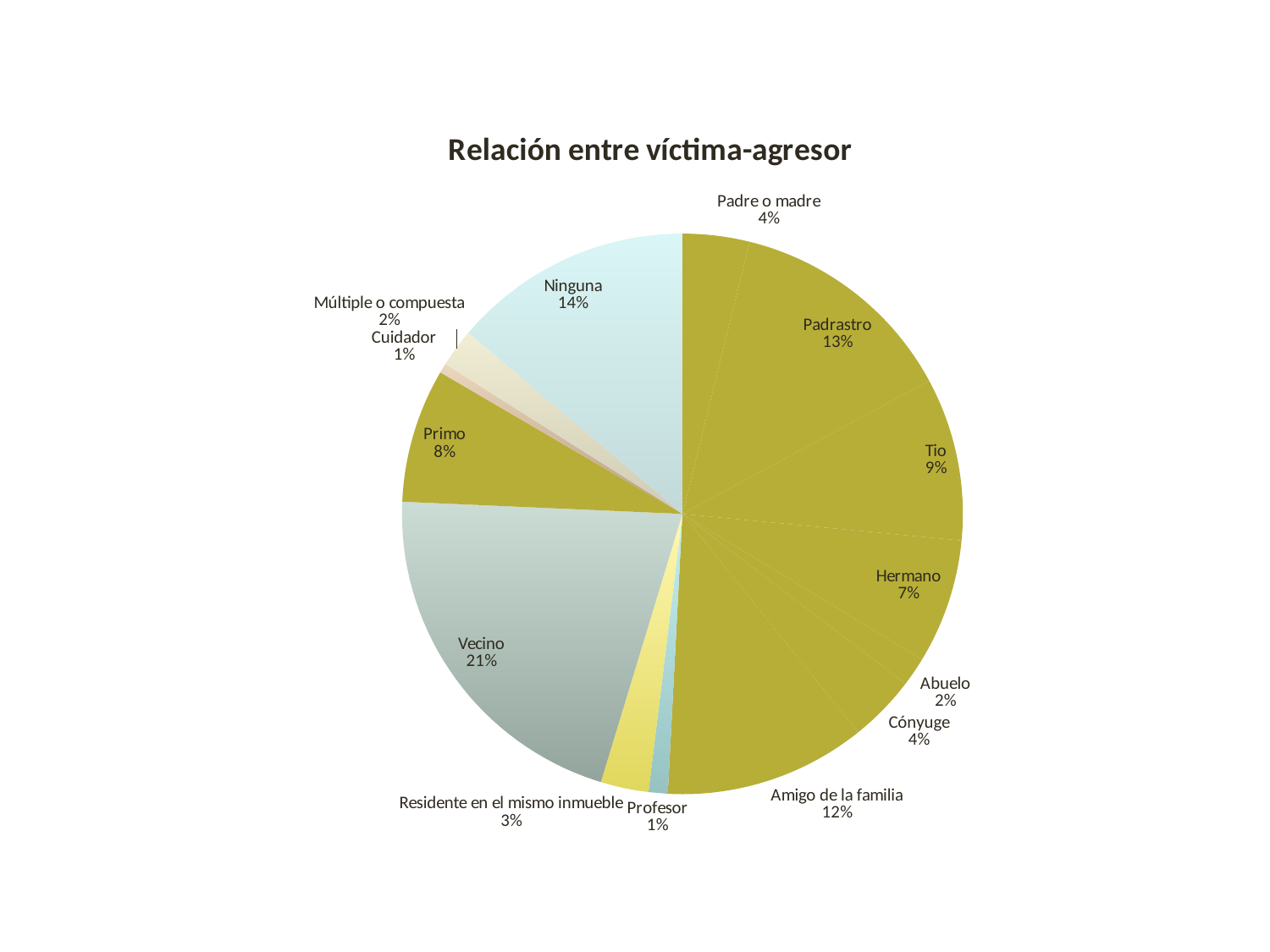
What share of the pie does Vecino represent? 21% What is the value for Padrastro? 13% Which is larger, Tio or Hermano? Tio Which category has the largest slice of the pie? Vecino What is the value for Amigo de la familia? 12% How many categories are shown in the pie chart? 14 What is the difference between the values for Vecino and Ninguna? 7% What is the title of the chart? Relación entre víctima-agresor What is the value for Residente en el mismo inmueble? 3% What is the value for Ninguna? 14% What type of chart is shown on the slide? pie chart What is the difference between the values for Padrastro and Primo? 5%